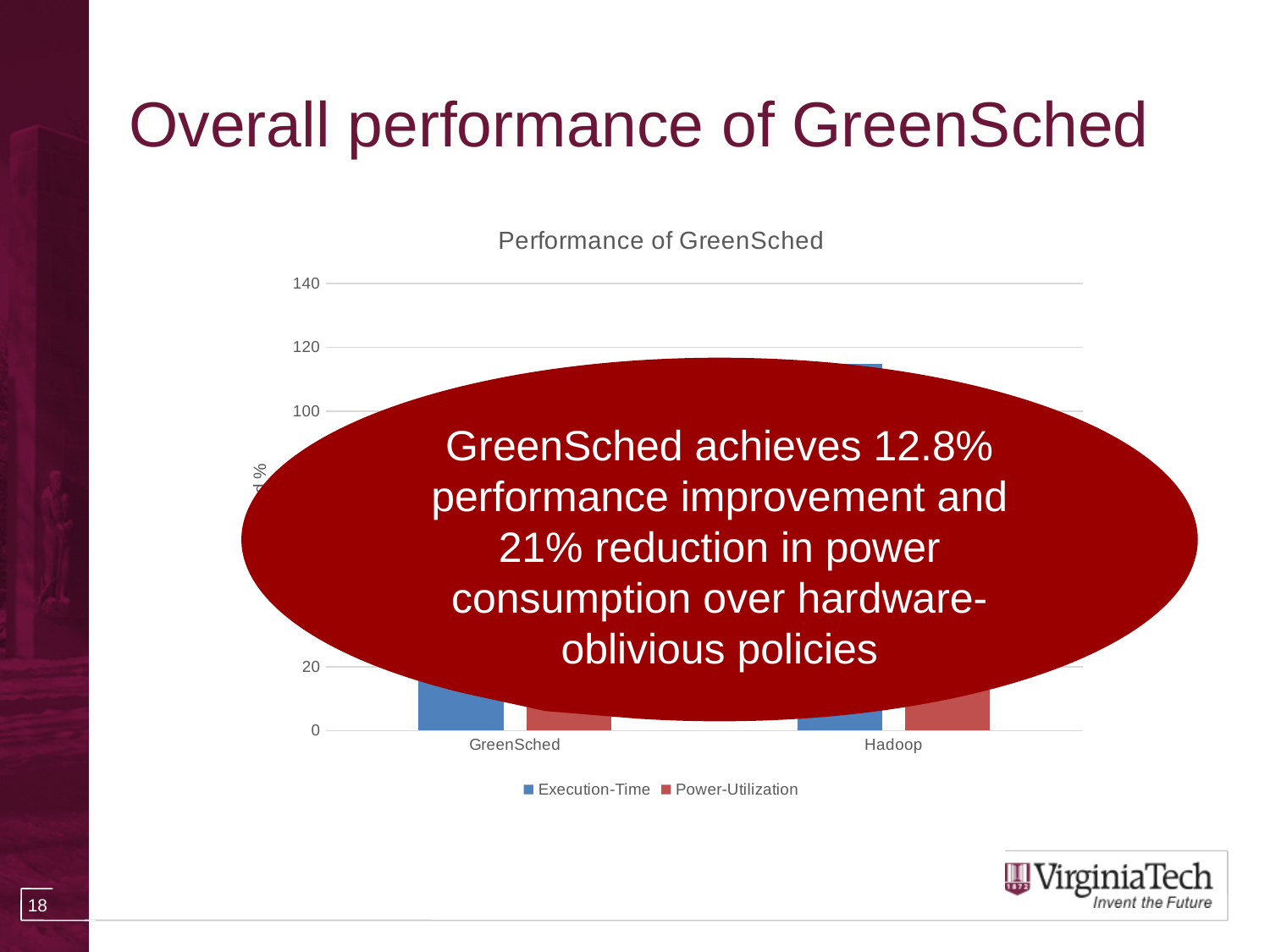
Is the Execution-Time value for Hadoop greater or less than 120? less Which colour represents the Execution-Time series in the chart? blue How many categories are shown on the x axis of the chart? 2 How many series does the chart's legend list? 2 What kind of chart is shown on the slide? bar chart Is the Execution-Time value for Hadoop greater or less than 100? greater What is the title of the chart? Performance of GreenSched